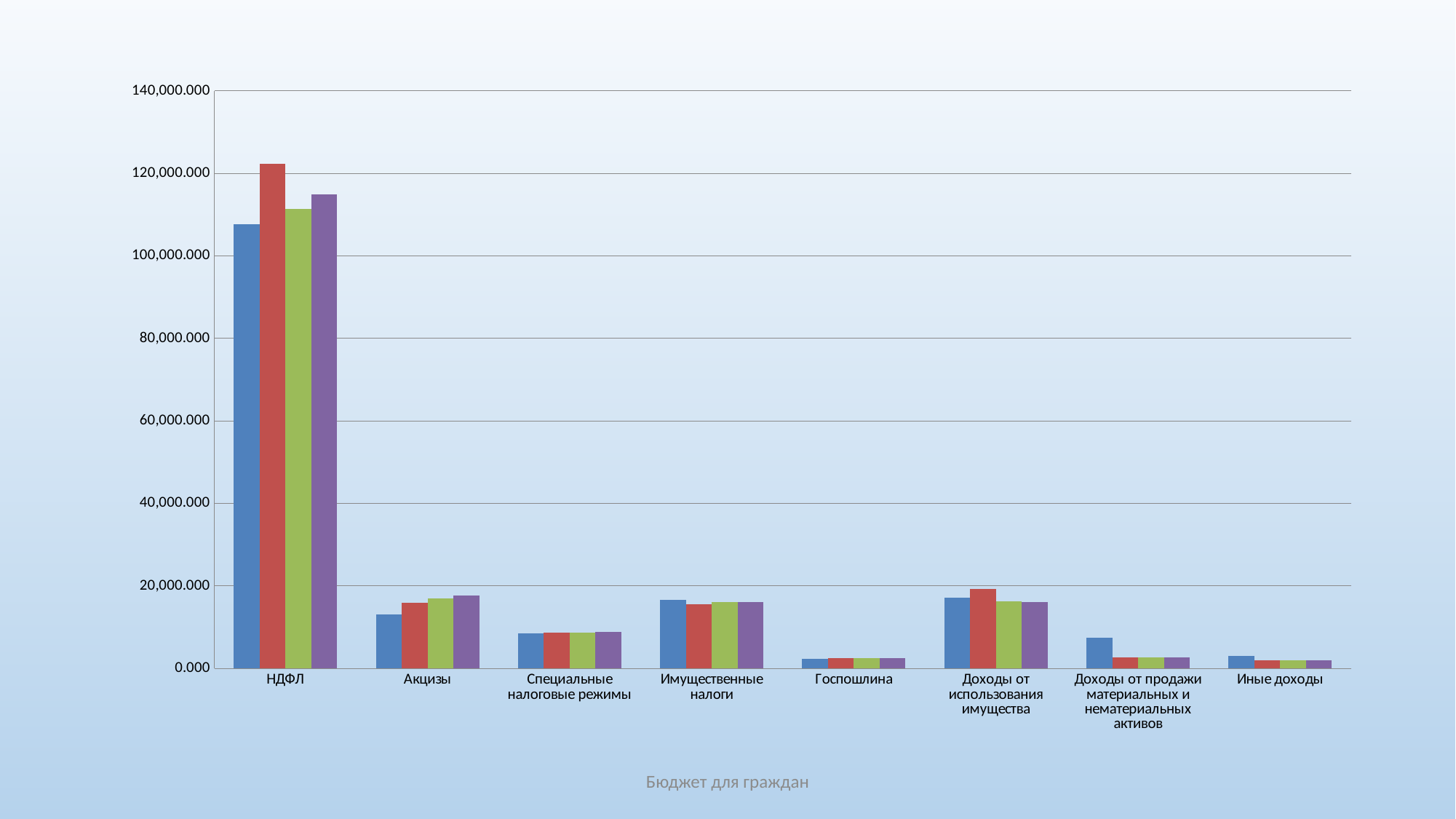
Which category has the highest values in the chart? НДФЛ How many bars are plotted for each category in the chart? 4 What kind of chart is shown on the slide? bar chart Which is larger, the blue bar for Имущественные налоги or the blue bar for Госпошлина? Имущественные налоги How many categories are shown on the x axis of the chart? 8 What text appears below the chart on the slide? Бюджет для граждан Which is larger, the blue bar for НДФЛ or the blue bar for Акцизы? НДФЛ